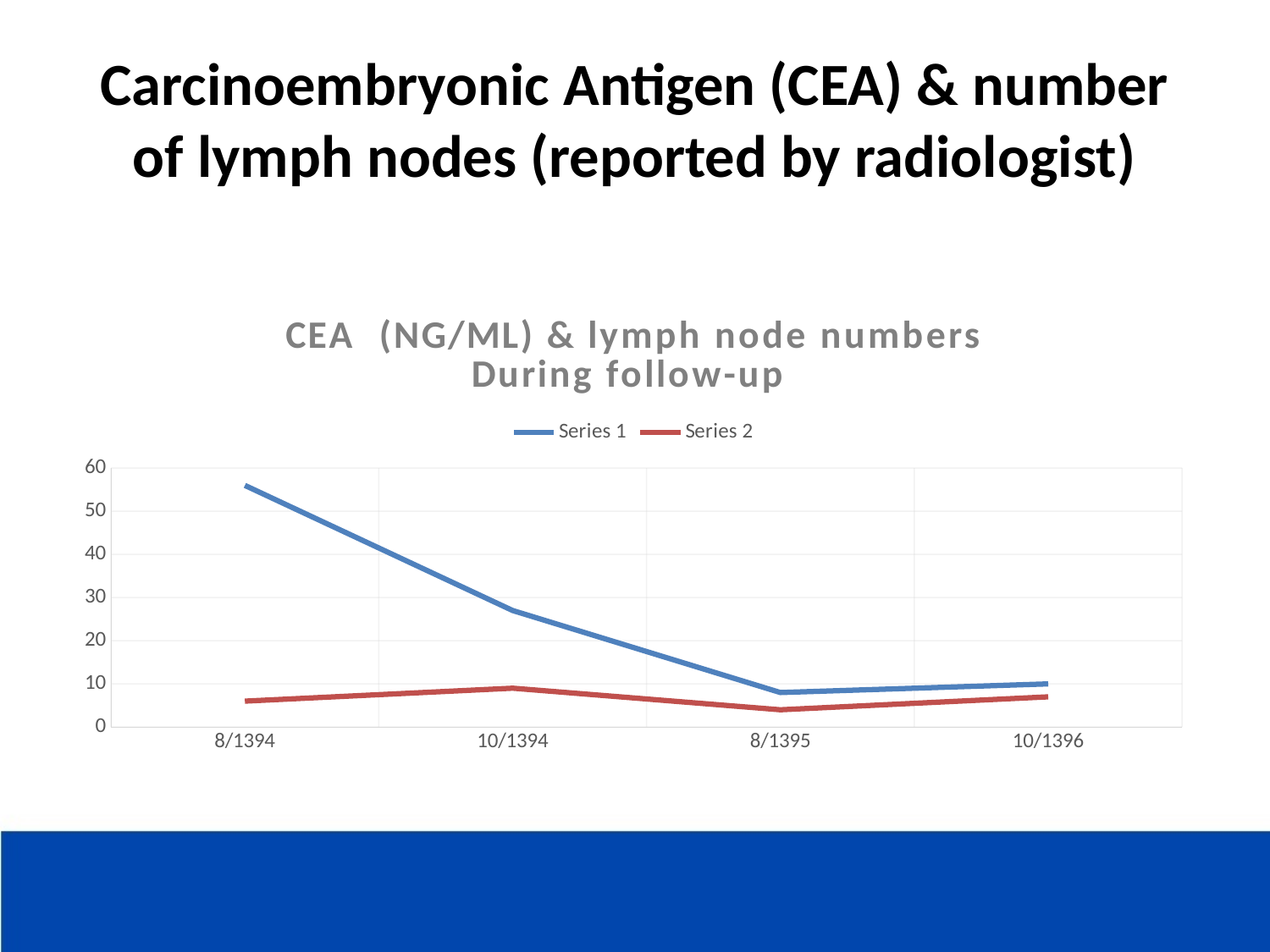
At which time point does Series 1 reach its highest value? 8/1394 At 10/1394, which series has the larger value, Series 1 or Series 2? Series 1 Is the value for Series 2 at 8/1394 greater or less than 10? less At 8/1394, which series has the larger value, Series 1 or Series 2? Series 1 How many time points are plotted along the x axis? 4 What kind of chart is shown on the slide? line chart What colour is the line for Series 2? red How many series does the legend list? 2 Is the value for Series 2 at 8/1395 greater or less than 10? less Is the value for Series 1 at 10/1394 greater or less than 20? greater Does Series 1 rise or fall from 8/1394 to 8/1395? fall